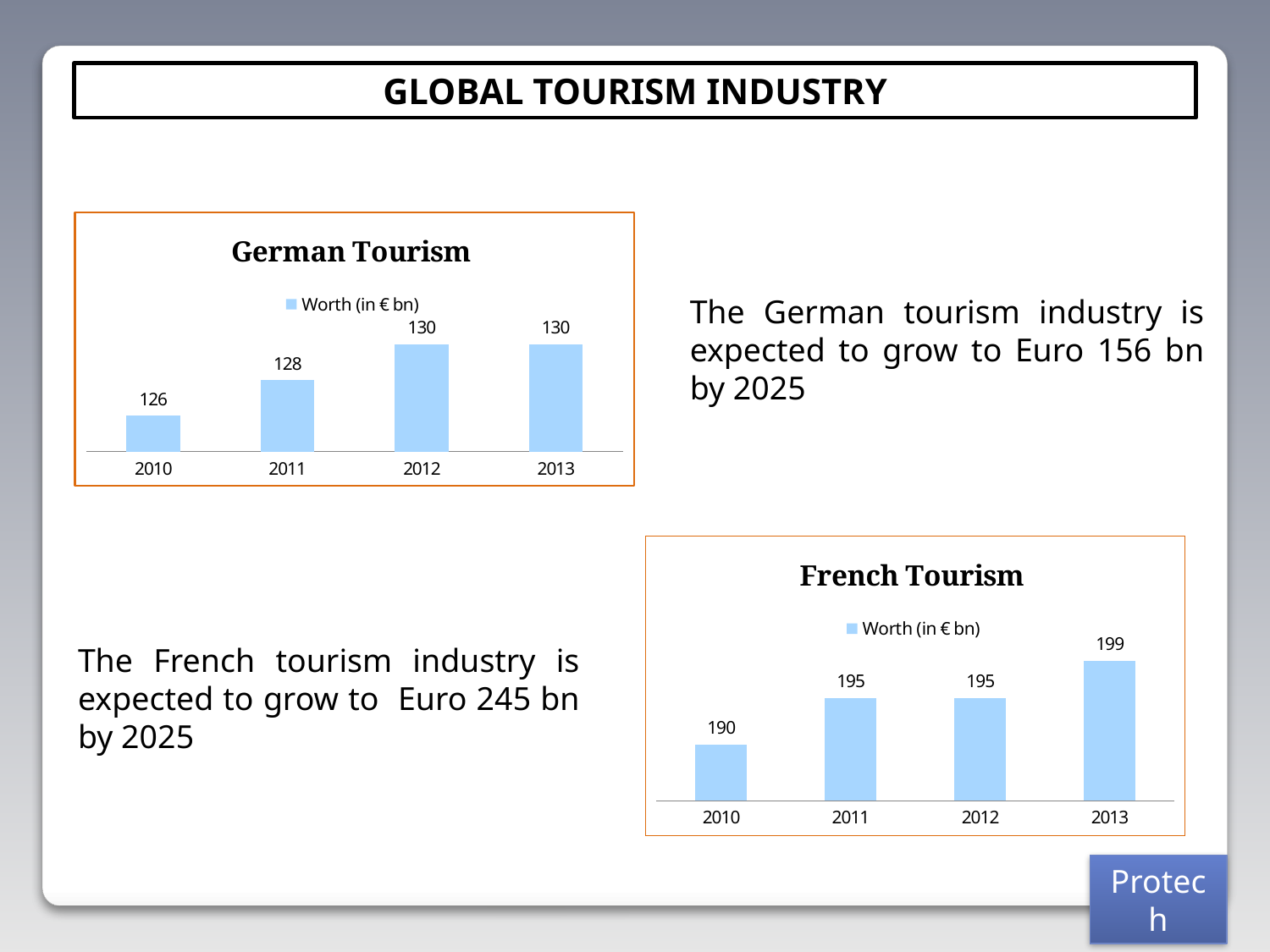
What kind of chart is the German Tourism chart? bar chart In the German Tourism chart, what is the worth (in € bn) for 2011? 128 In the German Tourism chart, what is the difference between the values for 2012 and 2010? 4 How many years are shown on the x axis of the German Tourism chart? 4 In the French Tourism chart, what is the worth (in € bn) for 2013? 199 How many series does the legend of the French Tourism chart list? 1 In the French Tourism chart, which is larger, the value for 2011 or the value for 2010? 2011 What is the legend entry shown in the German Tourism chart? Worth (in € bn) In the French Tourism chart, do the values generally rise or fall from 2010 to 2013? rise In the French Tourism chart, which year has the highest value? 2013 In the German Tourism chart, which year has the lowest value? 2010 In the French Tourism chart, what is the difference between the values for 2013 and 2010? 9